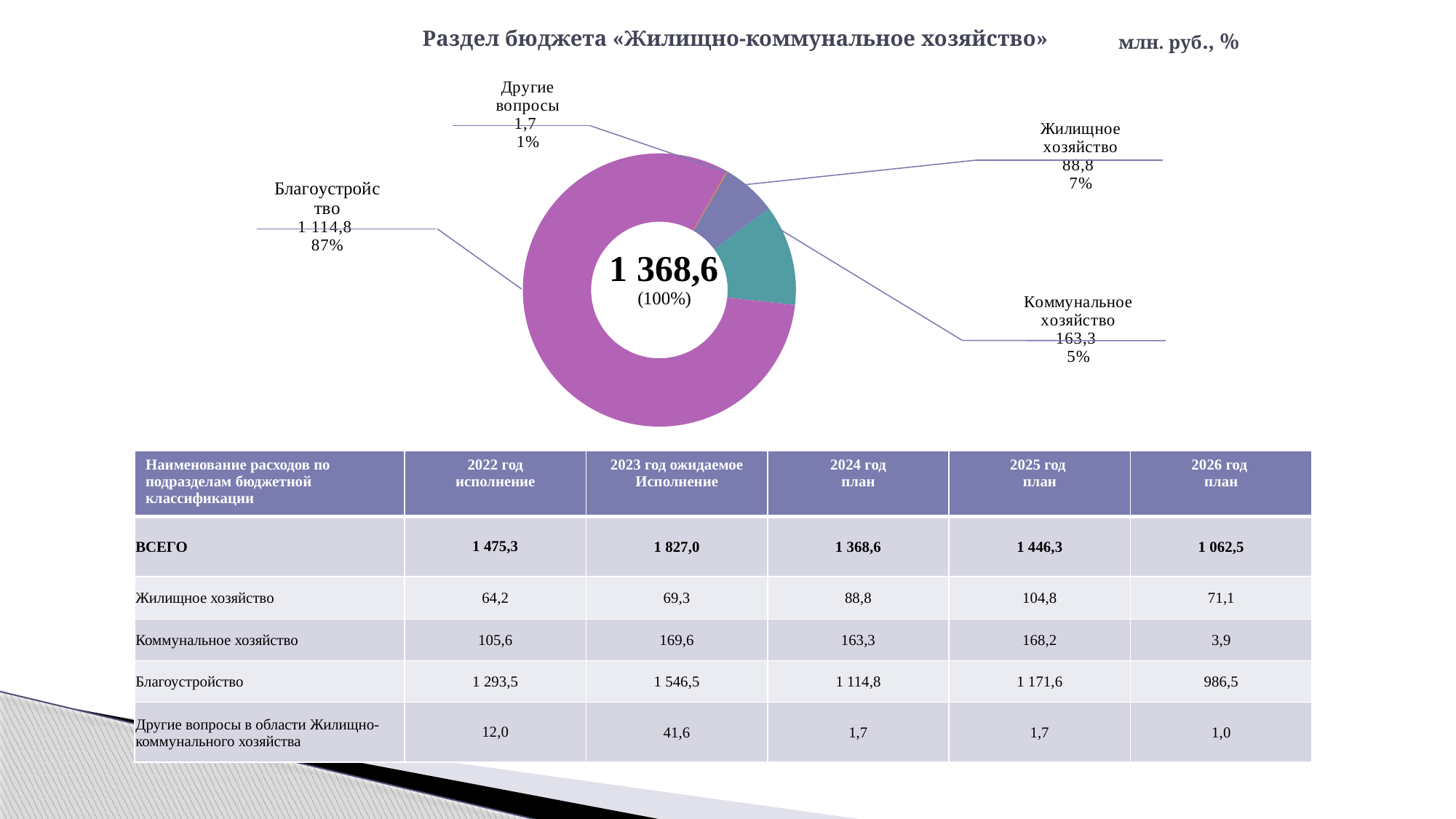
What share of the donut chart does Благоустройство represent, as labelled? 87% What is the value for Жилищное хозяйство in the donut chart? 88,8 Which category has the smallest slice in the donut chart? Другие вопросы What kind of chart is shown on the slide? Donut (pie) chart What is the value for Другие вопросы in the donut chart? 1,7 Which category has the largest slice in the donut chart? Благоустройство What is the value for Коммунальное хозяйство in the donut chart? 163,3 Which is larger in the donut chart: Коммунальное хозяйство or Жилищное хозяйство? Коммунальное хозяйство What is the value for Благоустройство in the donut chart? 1 114,8 What total is shown in the centre of the donut chart? 1 368,6 How many categories are shown in the donut chart? 4 What is the difference between the values for Коммунальное хозяйство and Жилищное хозяйство in the donut chart? 74,5